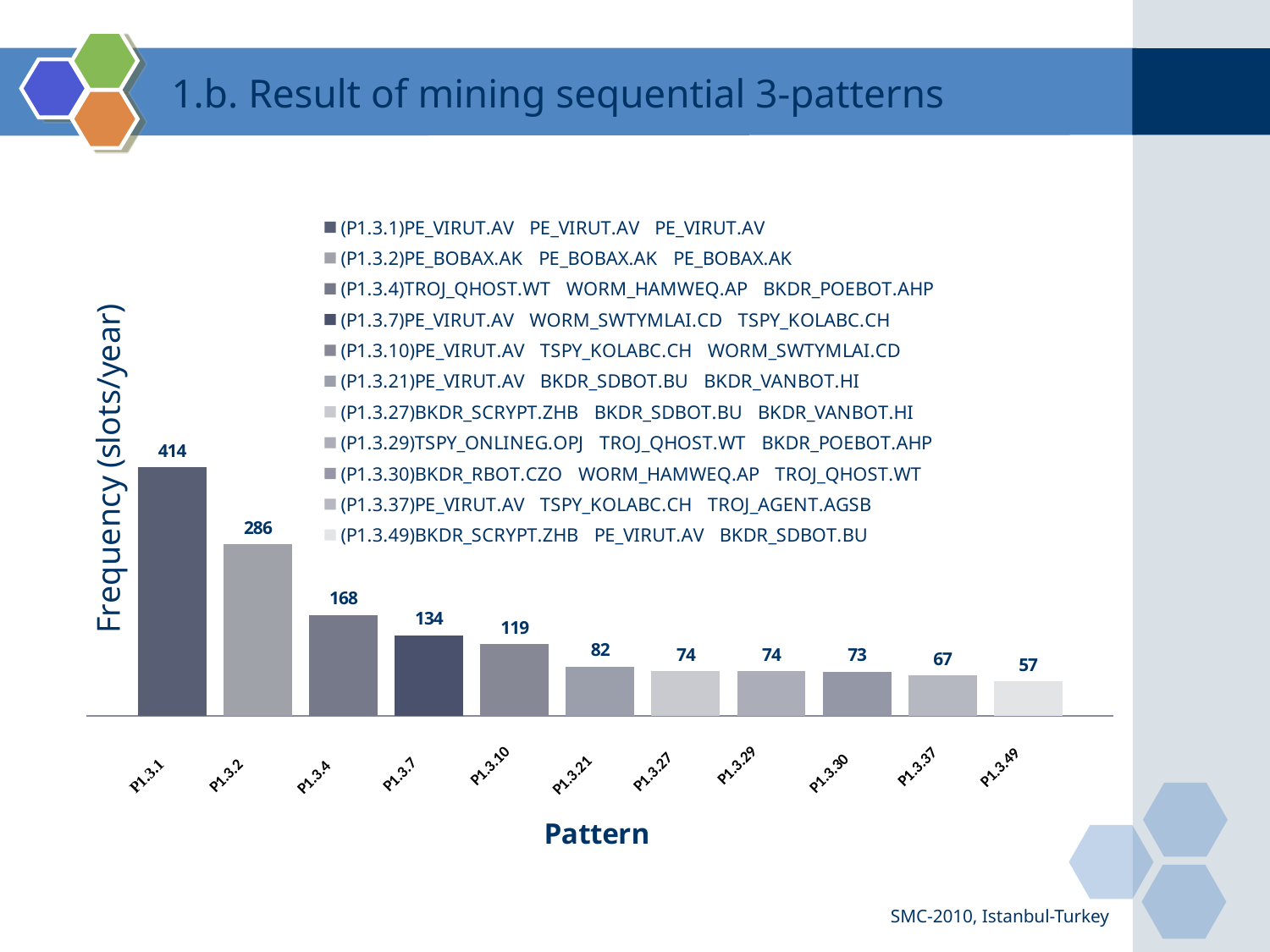
What is the frequency value for pattern P1.3.10? 119 Which pattern has the lowest frequency? P1.3.49 How many patterns are plotted on the x axis? 11 Which pattern has the highest frequency? P1.3.1 Which has a higher frequency, P1.3.21 or P1.3.30? P1.3.21 What kind of chart is shown on the slide? Bar chart What is the difference between the frequency of P1.3.1 and P1.3.2? 128 What is the difference between the frequency of P1.3.4 and P1.3.7? 34 What is the frequency value for pattern P1.3.1? 414 How many entries does the legend list? 11 What is the label of the y axis? Frequency (slots/year) What is the frequency value for pattern P1.3.37? 67